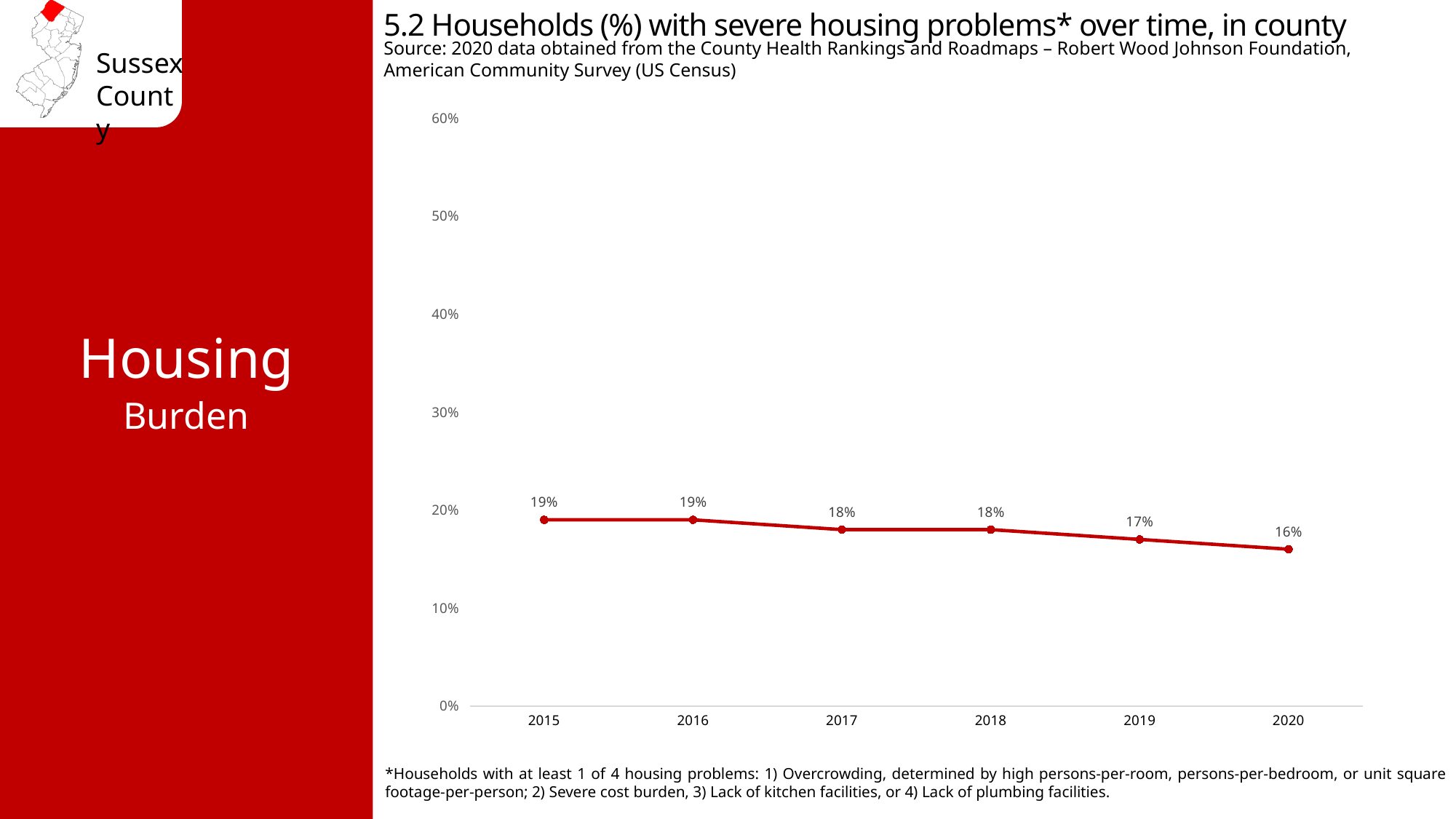
What kind of chart is shown on the slide? line chart What is the value shown for 2020? 16% What is the difference between the 2015 value and the 2020 value? 3% Which is larger, the value for 2017 or the value for 2020? 2017 What is the highest value shown on the y axis? 60% What is the title of the chart? 5.2 Households (%) with severe housing problems* over time, in county Do the values rise or fall from 2015 to 2020? fall Which year has the lowest percentage of households with severe housing problems? 2020 How many years are plotted on the chart? 6 What percentage of households had severe housing problems in 2015? 19% Is the value for 2019 greater or less than 20%? less What is the value shown for 2018? 18%